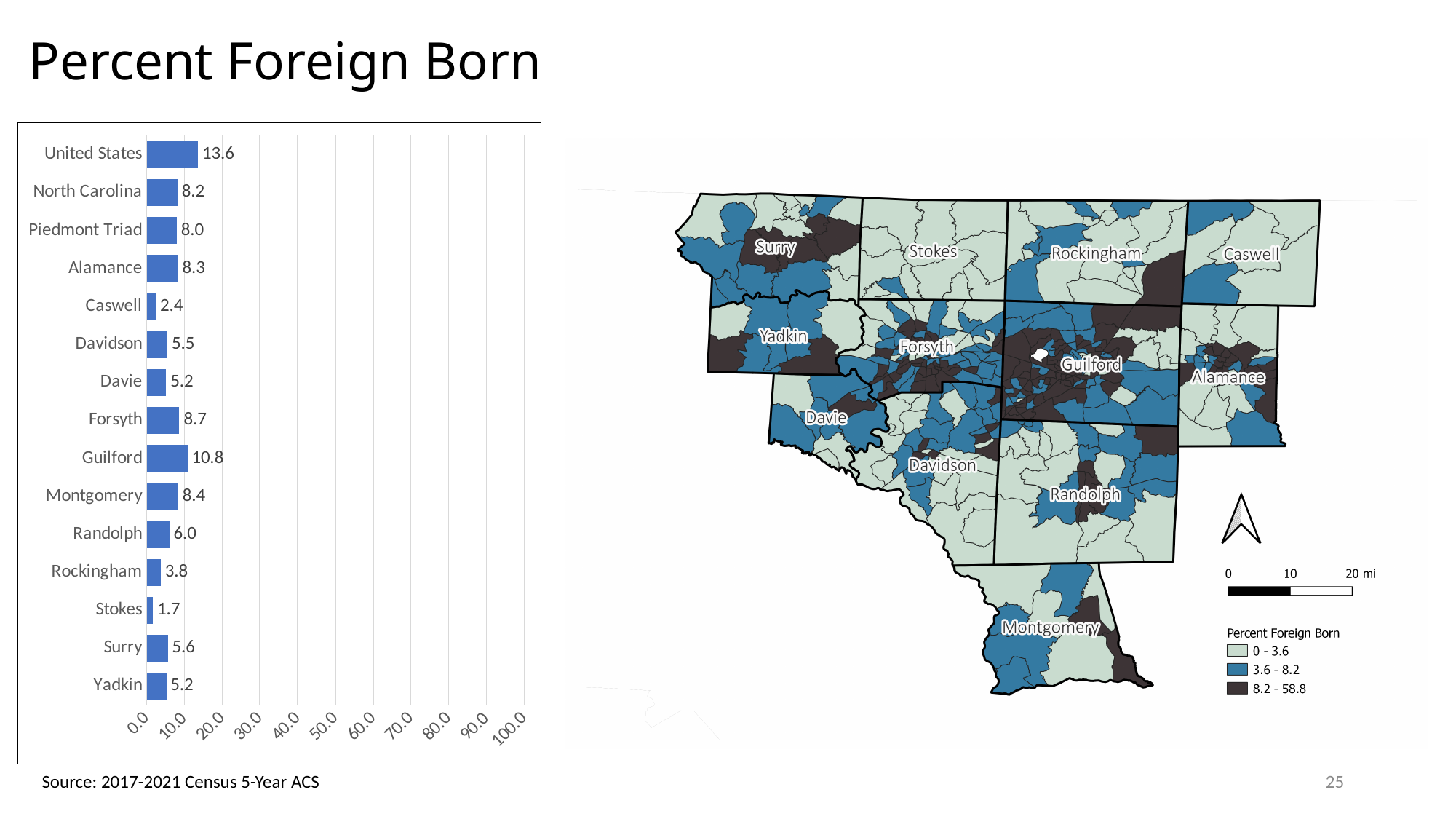
In the bar chart, which county has the highest percent foreign born? Guilford In the bar chart, what is the value shown for Caswell? 2.4 In the bar chart, which category has the highest percent foreign born? United States In the bar chart, what is the percent foreign born for Guilford? 10.8 In the bar chart, which is larger, the value for Montgomery or the value for Randolph? Montgomery In the bar chart, what is the percent foreign born for the United States? 13.6 In the bar chart, which category has the lowest percent foreign born? Stokes How many categories are shown in the bar chart? 15 What kind of chart is shown on the left side of the slide? Bar chart In the bar chart, what is the difference between the United States and North Carolina values? 5.4 In the bar chart, what is the difference between the values for Guilford and Forsyth? 2.1 In the bar chart, what is the value shown for Piedmont Triad? 8.0